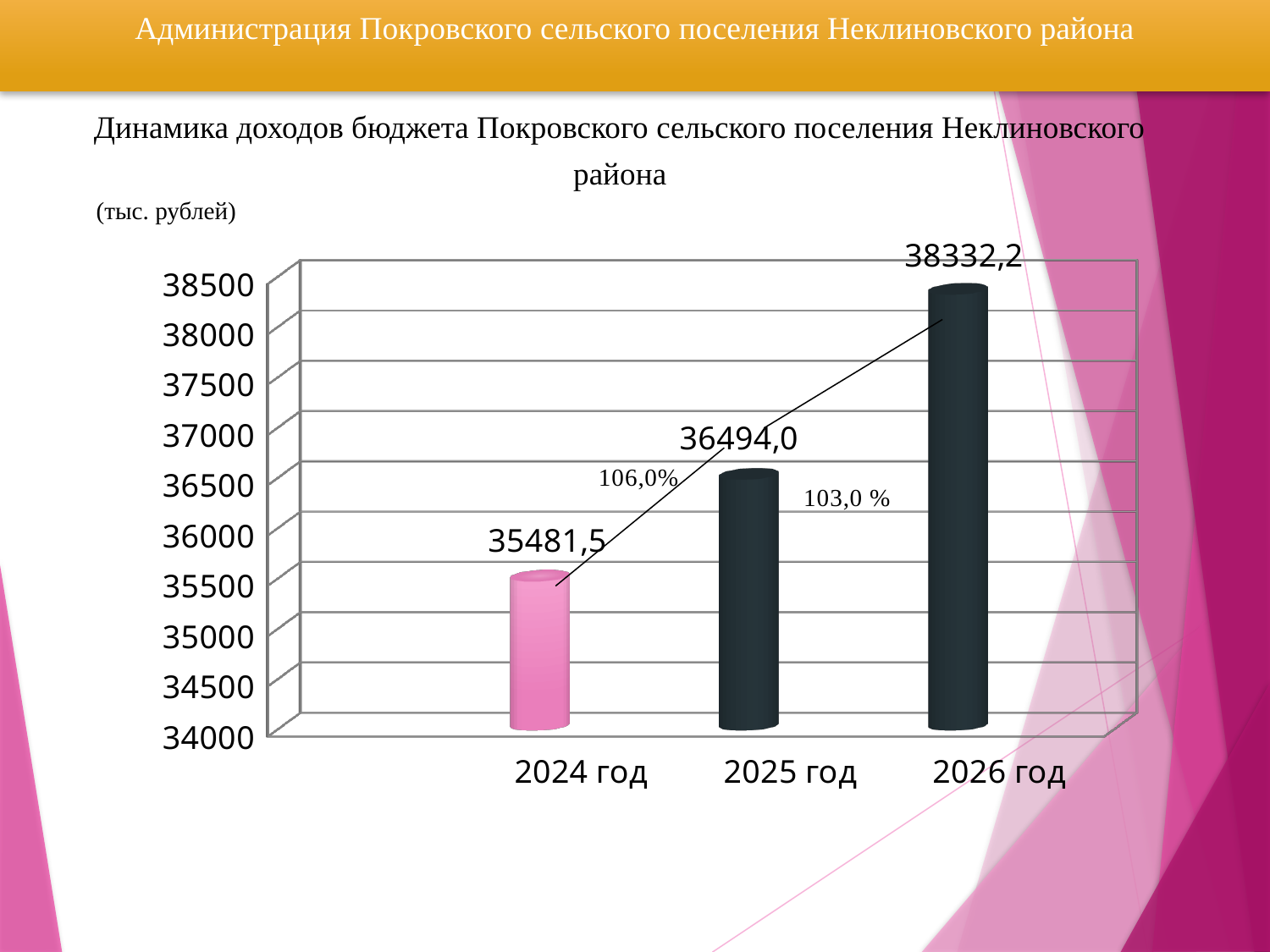
What is the budget revenue value shown for 2025 год? 36494,0 Do the budget revenue values rise or fall from 2024 год to 2026 год? rise What is the difference between the values for 2026 год and 2025 год? 1838,2 Which is larger, the value for 2025 год or the value for 2026 год? 2026 год Is the value for 2025 год greater or less than 36000? greater How many years (categories) are shown on the chart? 3 What type of chart is shown on the slide? bar chart Which year has the lowest budget revenue on the chart? 2024 год Which year has the highest budget revenue on the chart? 2026 год What is the budget revenue value shown for 2026 год? 38332,2 What is the budget revenue value shown for 2024 год? 35481,5 What is the difference between the values for 2025 год and 2024 год? 1012,5